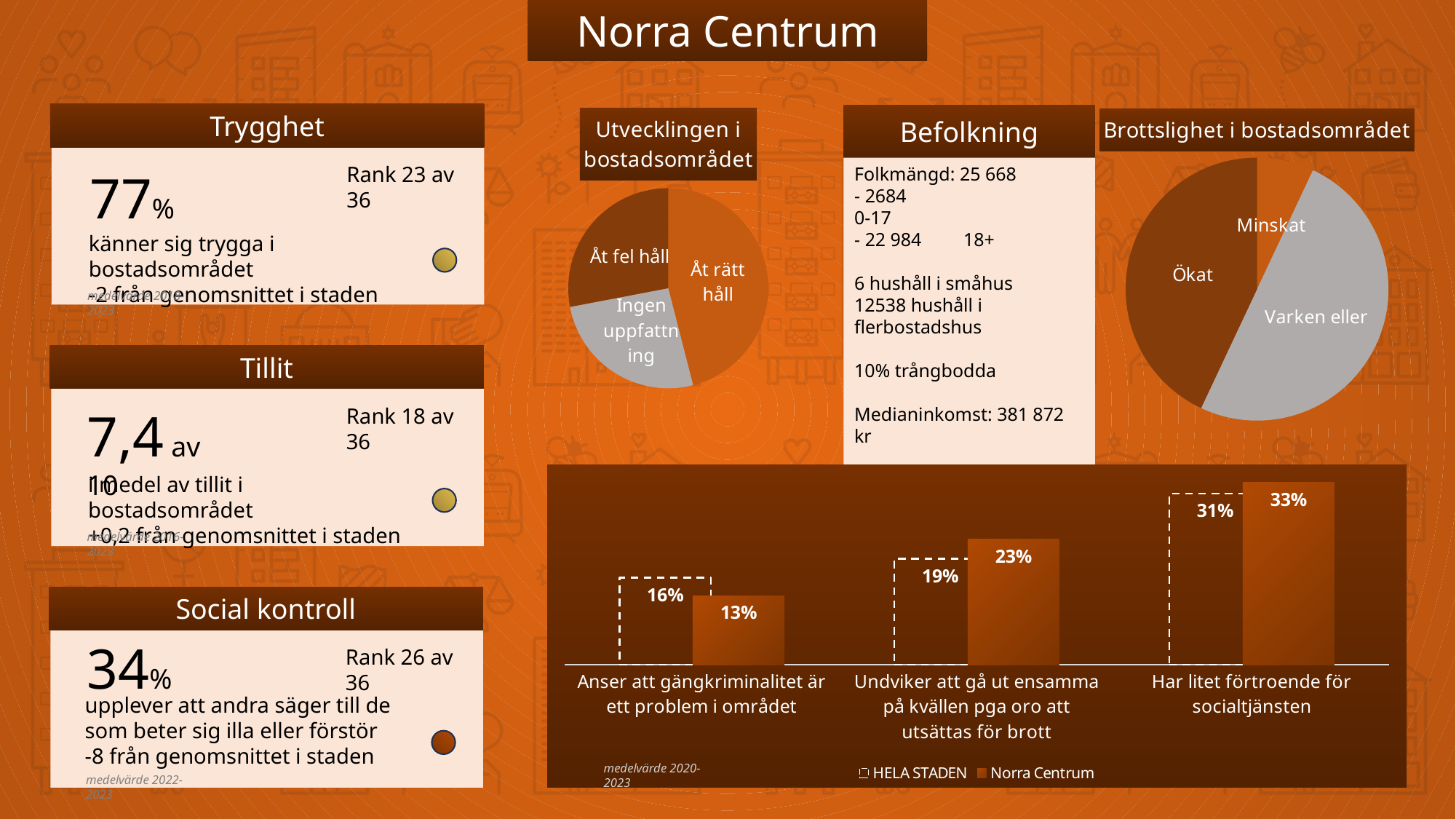
In the bar chart at the bottom of the slide, how many categories are shown? 3 In the bar chart at the bottom of the slide, what is the difference between Norra Centrum and HELA STADEN for 'Undviker att gå ut ensamma på kvällen pga oro att utsättas för brott'? 4 percentage points In the bar chart at the bottom of the slide, what is the value for HELA STADEN for 'Anser att gängkriminalitet är ett problem i området'? 16% In the bar chart at the bottom of the slide, what is the value for Norra Centrum for 'Undviker att gå ut ensamma på kvällen pga oro att utsättas för brott'? 23% In the pie chart 'Brottslighet i bostadsområdet', which slice is the smallest? Minskat In the bar chart at the bottom of the slide, which category has the lowest value for HELA STADEN? Anser att gängkriminalitet är ett problem i området In the bar chart at the bottom of the slide, how many series does the legend list? 2 What kind of chart is 'Utvecklingen i bostadsområdet'? Pie chart In the bar chart at the bottom of the slide, which category has the highest value for Norra Centrum? Har litet förtroende för socialtjänsten In the bar chart at the bottom of the slide, what is the value for Norra Centrum for 'Har litet förtroende för socialtjänsten'? 33% In the bar chart at the bottom of the slide, which is larger for 'Anser att gängkriminalitet är ett problem i området': HELA STADEN or Norra Centrum? HELA STADEN In the pie chart 'Utvecklingen i bostadsområdet', which slice is the largest? Åt rätt håll